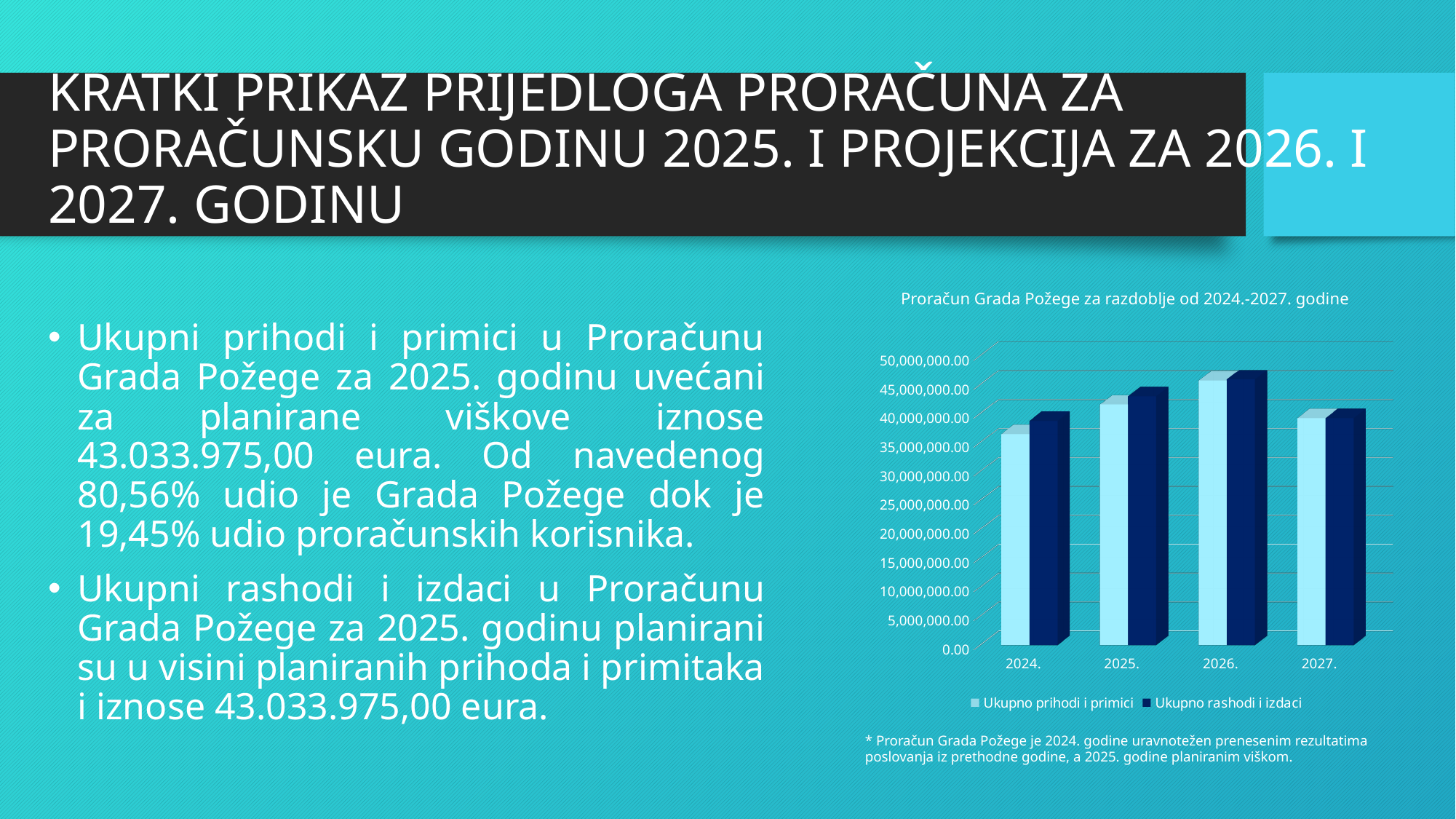
In which year is the value for Ukupno rashodi i izdaci highest? 2026. What type of chart is shown on the slide? bar chart Which series is shown in dark blue in the chart? Ukupno rashodi i izdaci Do the values for Ukupno prihodi i primici rise or fall from 2024. to 2026.? rise In which year is the value for Ukupno prihodi i primici lowest? 2024. What is the title of the chart? Proračun Grada Požege za razdoblje od 2024.-2027. godine How many series does the chart legend list? 2 Is the value for Ukupno prihodi i primici in 2026. greater or less than 40,000,000.00? greater Is the value for Ukupno rashodi i izdaci in 2027. greater or less than 45,000,000.00? less In which year is the value for Ukupno prihodi i primici highest? 2026. How many year categories are shown on the x axis of the chart? 4 Is the value for Ukupno prihodi i primici in 2024. greater or less than 40,000,000.00? less